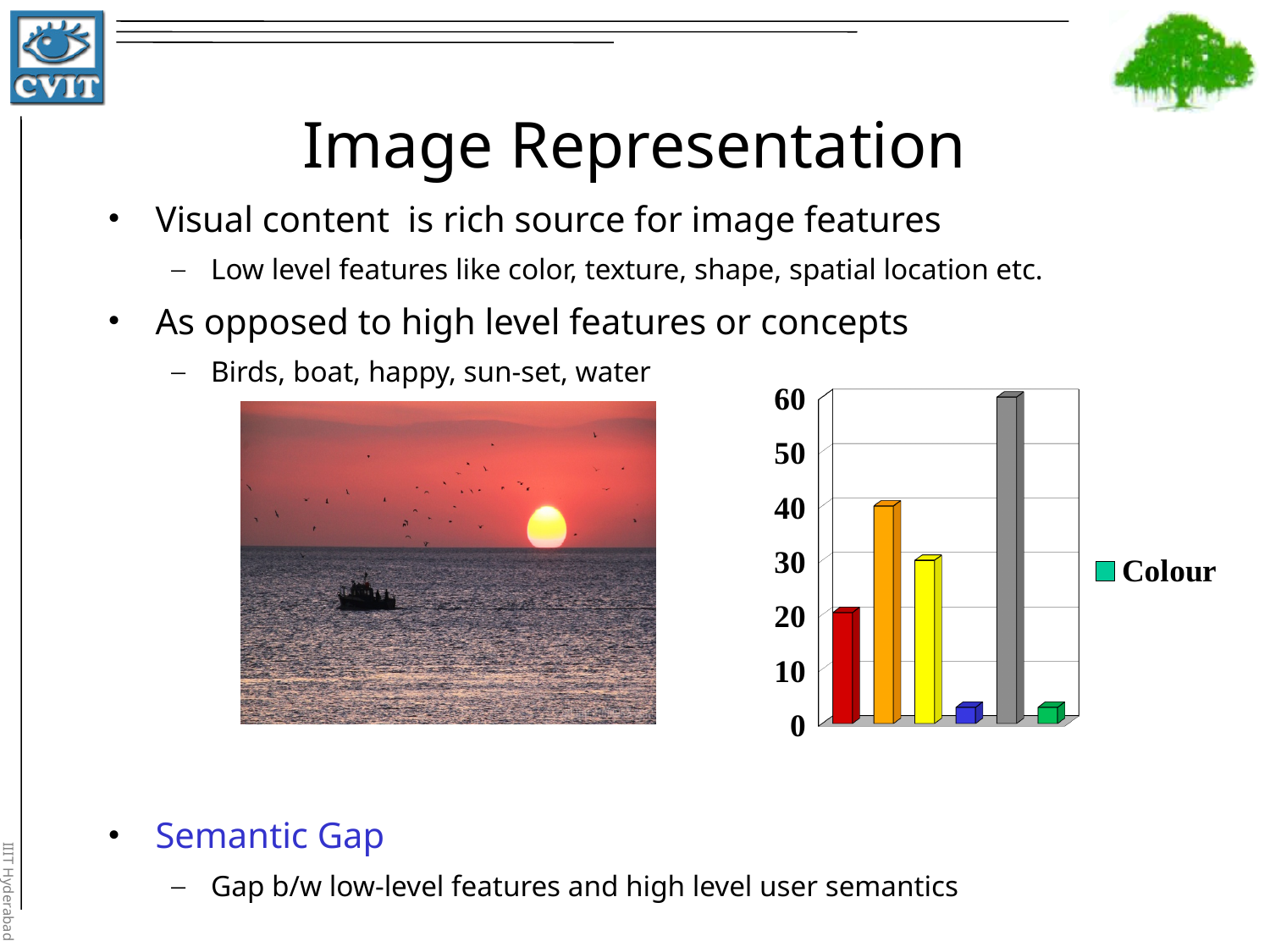
Is the value of the orange bar (second from left) greater or less than 30? greater Is the value of the grey bar (fifth from left) greater or less than 50? greater Which is larger, the red bar or the yellow bar? the yellow bar How many series does the chart's legend list? 1 What kind of chart is shown on the slide? bar chart Is the value of the red bar (first from left) greater or less than 30? less What is the highest value shown on the chart's vertical axis? 60 Which bar is the tallest in the chart? the grey bar (fifth from left) What is the legend entry shown next to the chart? Colour How many bars are plotted in the chart? 6 Which is larger, the orange bar or the yellow bar? the orange bar